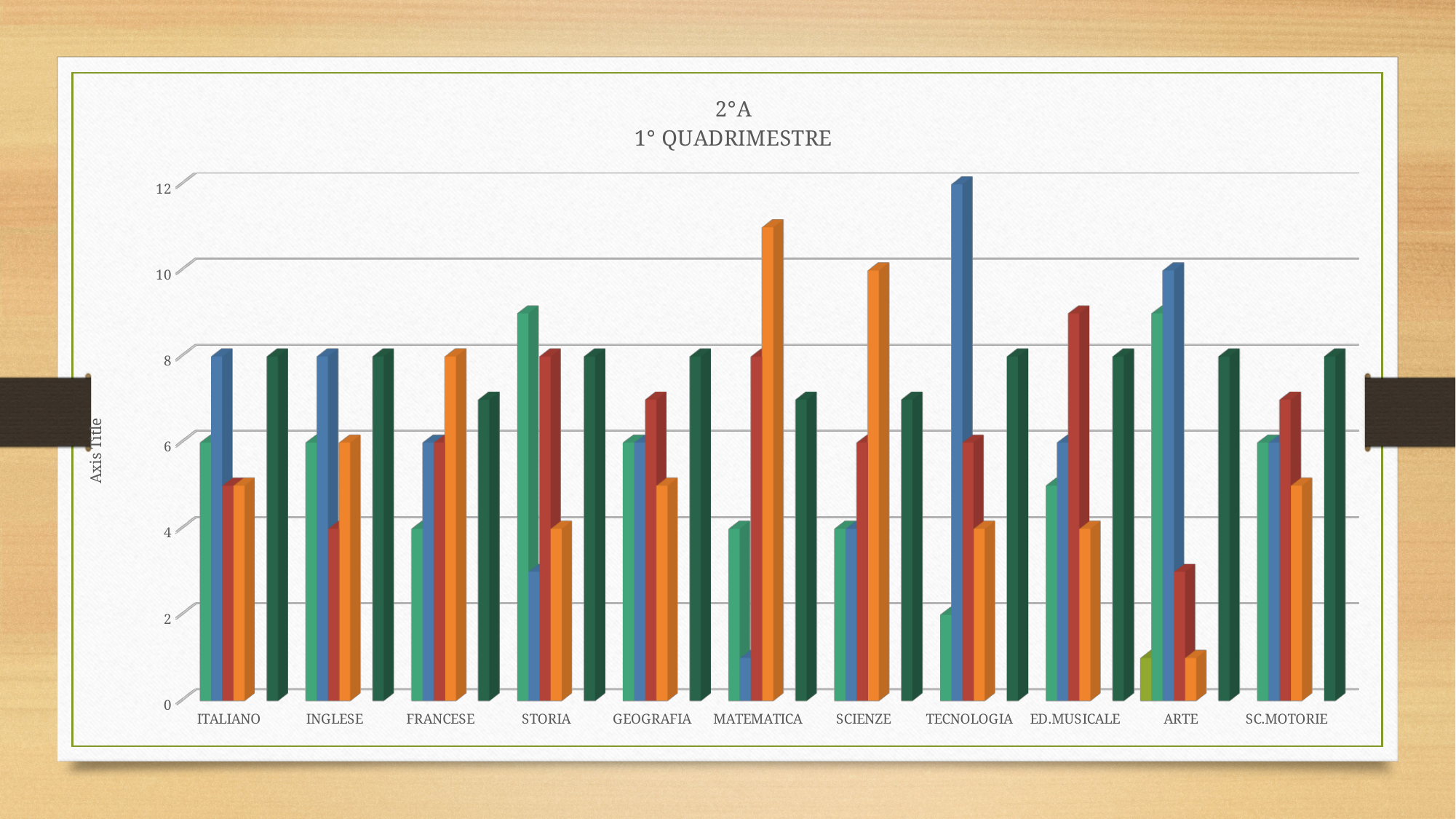
Which is larger, the blue bar for TECNOLOGIA or the blue bar for ARTE? TECNOLOGIA Is the blue bar for TECNOLOGIA greater or less than 10? greater What type of chart is shown on the slide? Bar chart What is the label on the vertical axis? Axis Title What is the title of the chart? 2°A 1° QUADRIMESTRE Is the red bar for ED.MUSICALE greater or less than 8? greater Which category has the tallest orange bar? MATEMATICA Is the blue bar for MATEMATICA greater or less than 2? less How many subject categories are shown on the x axis? 11 Which category has the tallest blue bar? TECNOLOGIA